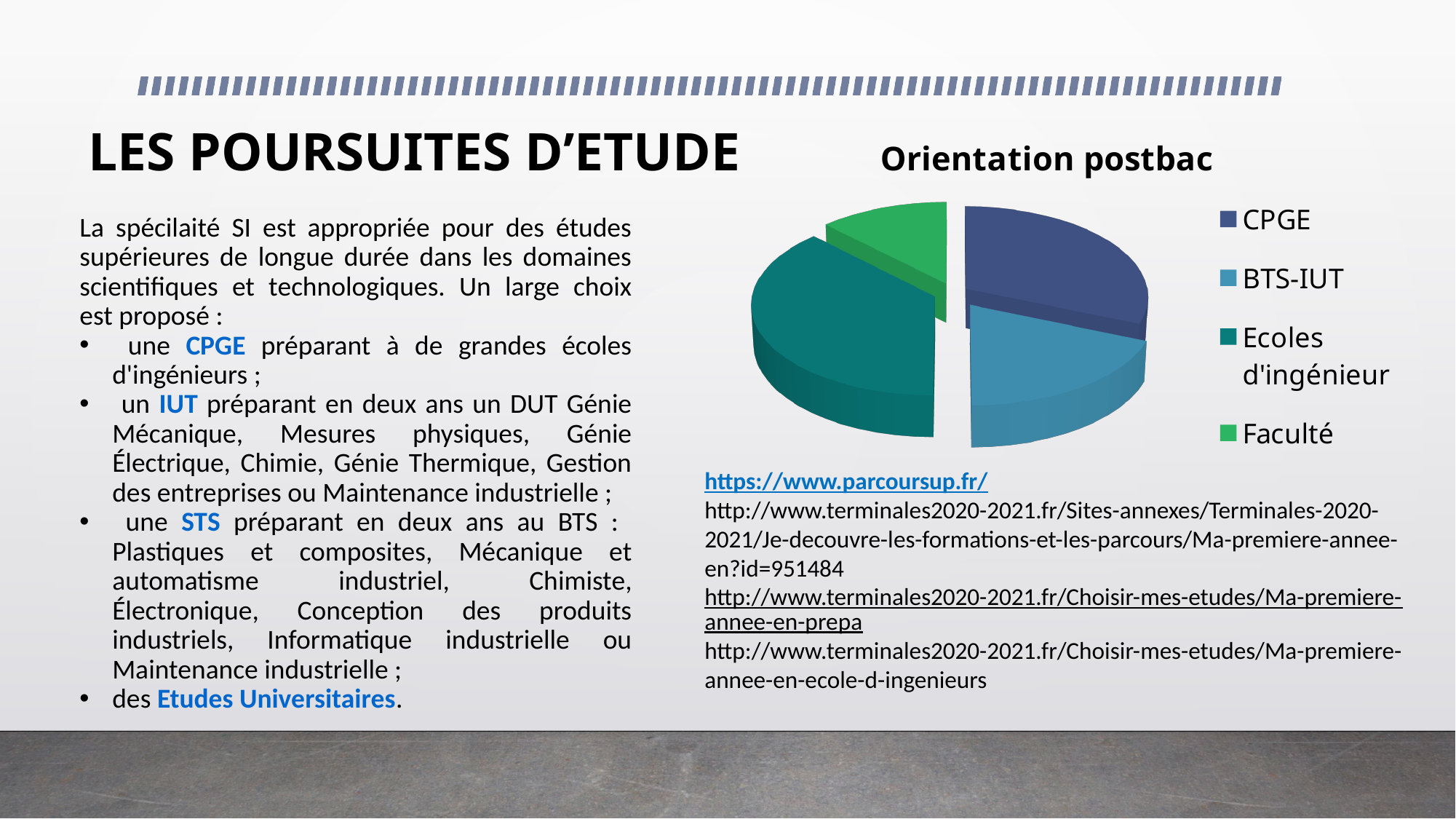
What kind of chart is shown on the slide? pie chart Which category has the smallest slice in the pie chart? Faculté Which slice is larger, Ecoles d'ingénieur or Faculté? Ecoles d'ingénieur Which slice is larger, BTS-IUT or Faculté? BTS-IUT Which category is shown in green in the pie chart? Faculté How many categories does the pie chart show? 4 What is the title of the chart on the slide? Orientation postbac How many entries does the chart legend list? 4 Which slice is larger, CPGE or Faculté? CPGE